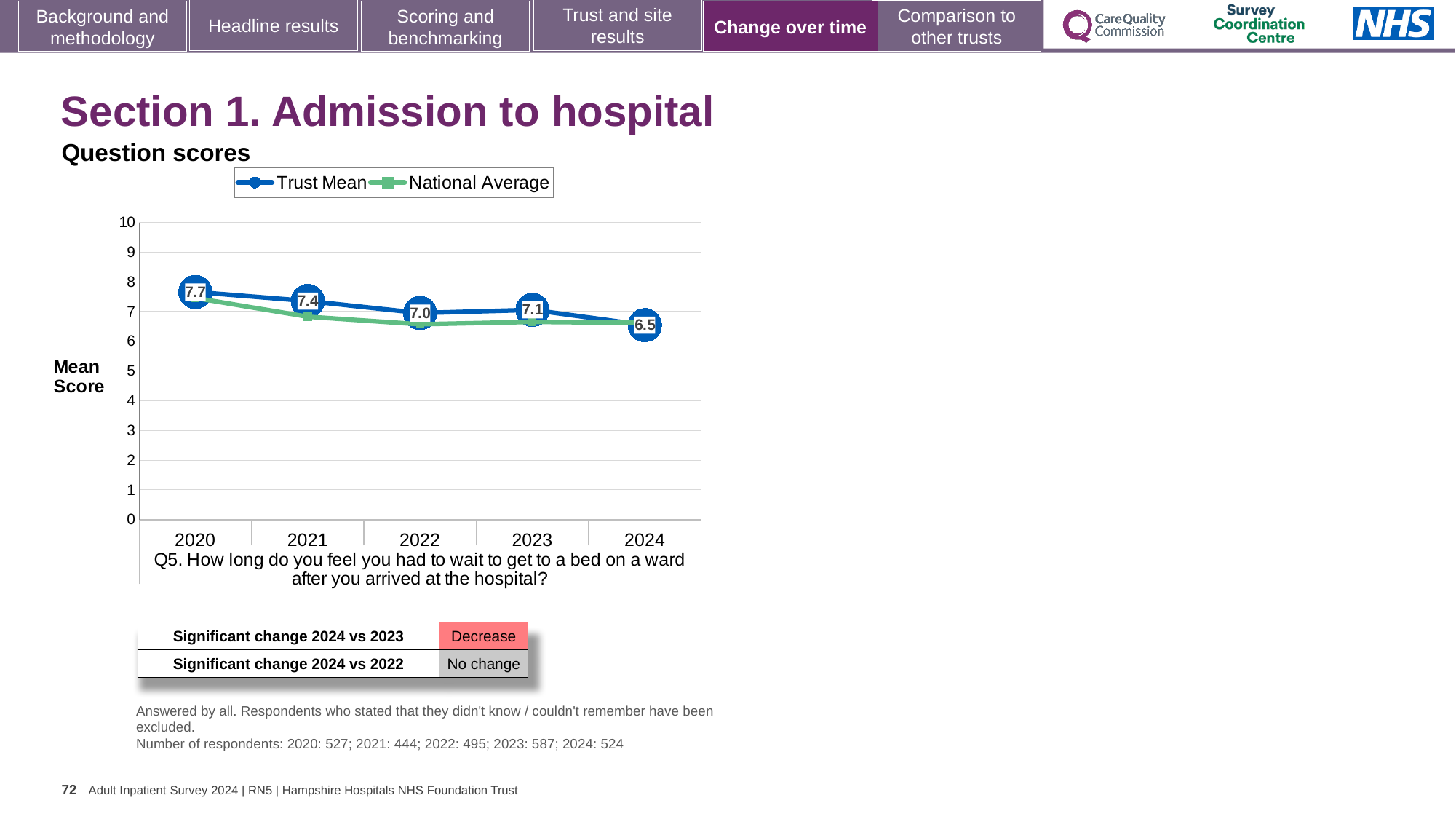
Which year has the higher Trust Mean score, 2021 or 2023? 2021 How many years are plotted on the x axis of the chart? 5 What kind of chart is shown on the slide? Line chart How many series does the chart legend list? 2 What is the difference between the Trust Mean score in 2020 and in 2024? 1.2 In which year is the Trust Mean score lowest? 2024 Is the National Average value for 2020 greater or less than 7? greater What is the Trust Mean score for 2022? 7.0 What is the Trust Mean score for 2020? 7.7 Does the Trust Mean score generally rise or fall from 2020 to 2024? Fall In which year is the Trust Mean score highest? 2020 What is the Trust Mean score for 2024? 6.5